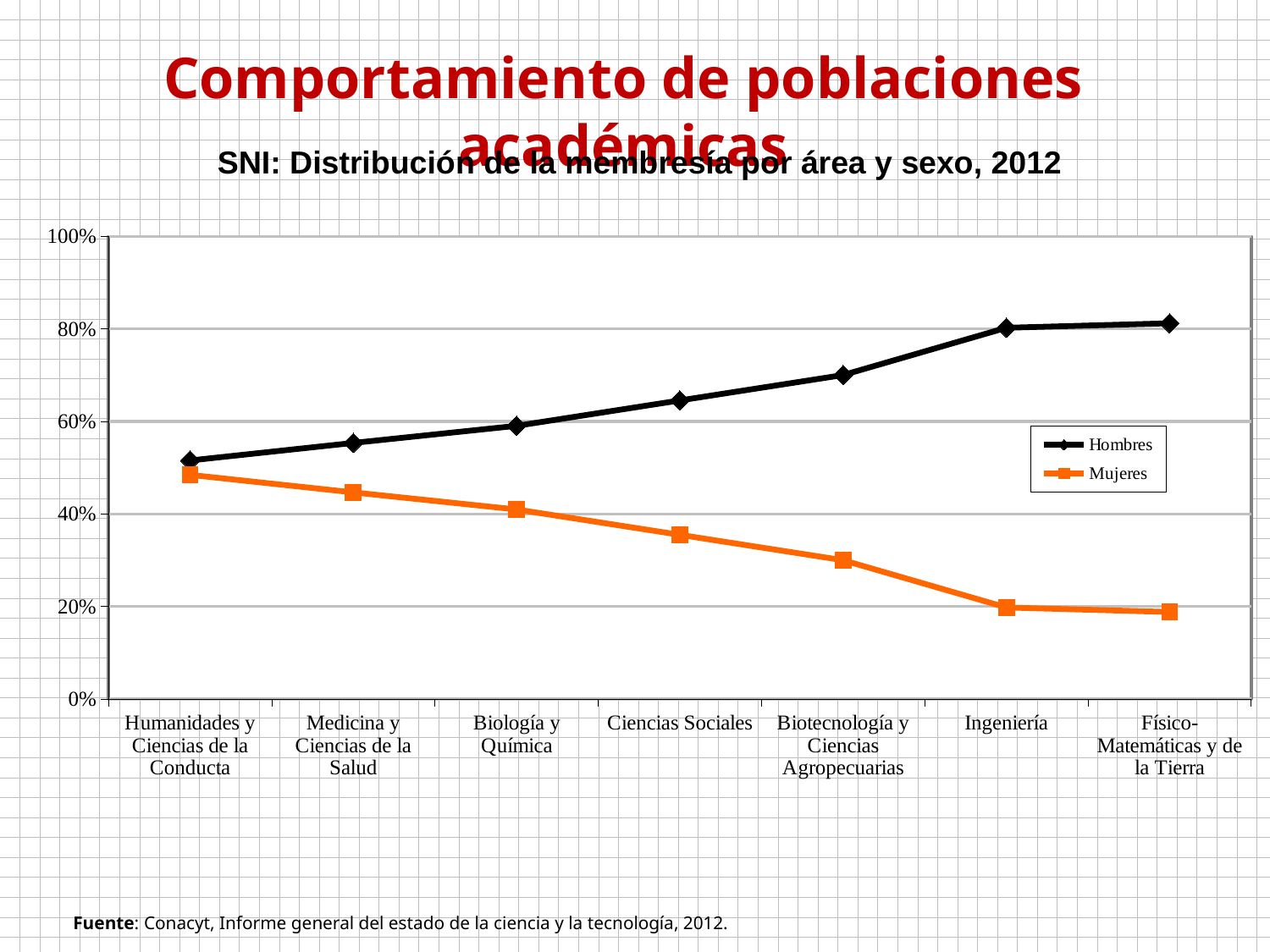
How many series does the legend list? 2 Does the Mujeres line rise or fall from left to right across the areas? Fall Is the Hombres value for Humanidades y Ciencias de la Conducta greater or less than 60%? less What kind of chart is shown on the slide? Line chart How many areas (categories) are plotted along the x axis? 7 For Ciencias Sociales, which series has the larger value, Hombres or Mujeres? Hombres In which area is the Hombres share lowest? Humanidades y Ciencias de la Conducta Is the Hombres value for Ingeniería greater or less than 60%? greater Is the Mujeres value for Humanidades y Ciencias de la Conducta greater or less than 40%? greater In which area is the Mujeres share highest? Humanidades y Ciencias de la Conducta